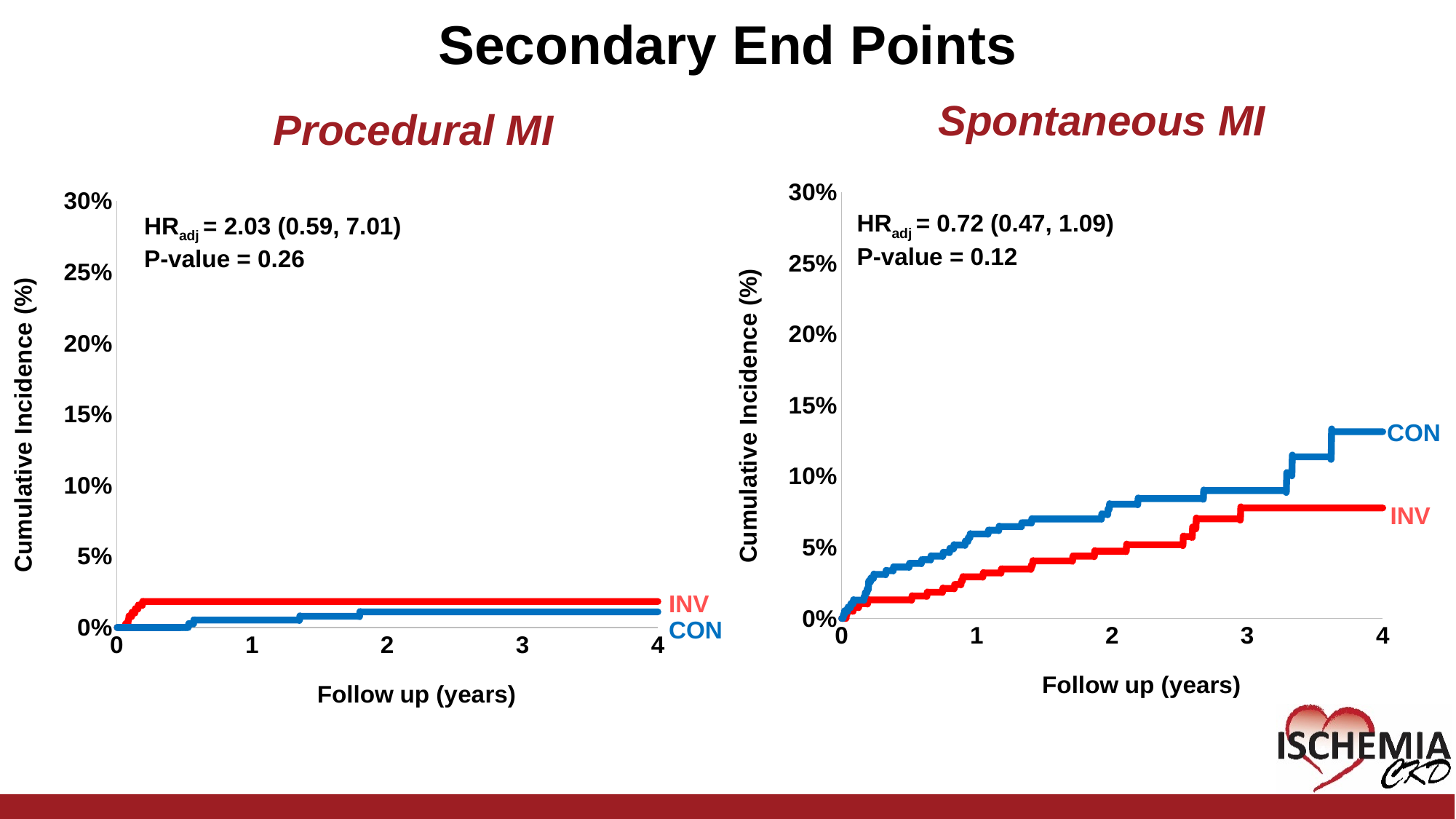
In the Procedural MI chart, is the cumulative incidence for INV at 4 years greater or less than 5%? less In the Procedural MI chart, which series has the higher cumulative incidence at 4 years, INV or CON? INV In the Spontaneous MI chart, which series has the higher cumulative incidence at 4 years, CON or INV? CON In the Procedural MI chart, what is the adjusted hazard ratio shown? 2.03 (0.59, 7.01) In the Spontaneous MI chart, is the cumulative incidence for INV at 1 year greater or less than 5%? less In the Spontaneous MI chart, how many series are plotted? 2 In the Spontaneous MI chart, does the cumulative incidence for CON rise or fall over the follow-up period? rise In the Spontaneous MI chart, is the cumulative incidence for INV at 4 years greater or less than 10%? less In the Procedural MI chart, what kind of chart is shown? line chart In the Spontaneous MI chart, what P-value is shown? 0.12